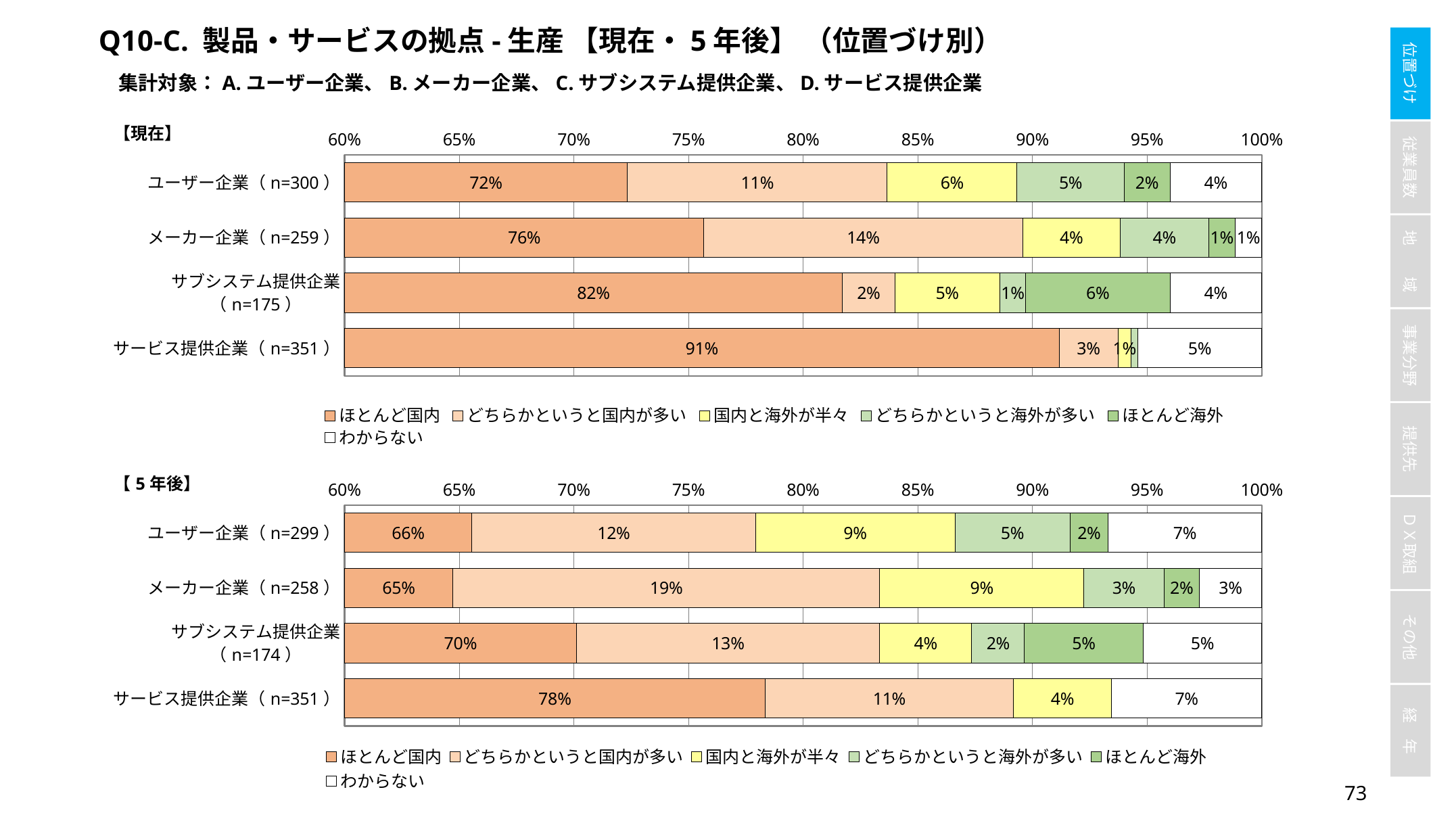
What kind of chart is the 【現在】 chart? Stacked bar chart In the 【5年後】 chart, what is the value of 国内と海外が半々 for ユーザー企業 (n=299)? 9% In the 【5年後】 chart, what is the value of ほとんど海外 for サブシステム提供企業 (n=174)? 5% In the 【5年後】 chart, what is the value of わからない for サービス提供企業 (n=351)? 7% In the 【現在】 chart, which category has the highest value for ほとんど国内? サービス提供企業 (n=351) In the 【現在】 chart, what is the value of ほとんど国内 for サービス提供企業 (n=351)? 91% How many series does the legend of the 【現在】 chart list? 6 In the 【5年後】 chart, which is larger for メーカー企業 (n=258): どちらかというと国内が多い or 国内と海外が半々? どちらかというと国内が多い In the 【現在】 chart, what is the difference between the ほとんど国内 values for サブシステム提供企業 (n=175) and ユーザー企業 (n=300)? 10% In the 【現在】 chart, what is the value of どちらかというと国内が多い for メーカー企業 (n=259)? 14% In the 【5年後】 chart, which category has the lowest value for ほとんど国内? メーカー企業 (n=258) How many categories are shown in the 【5年後】 chart? 4